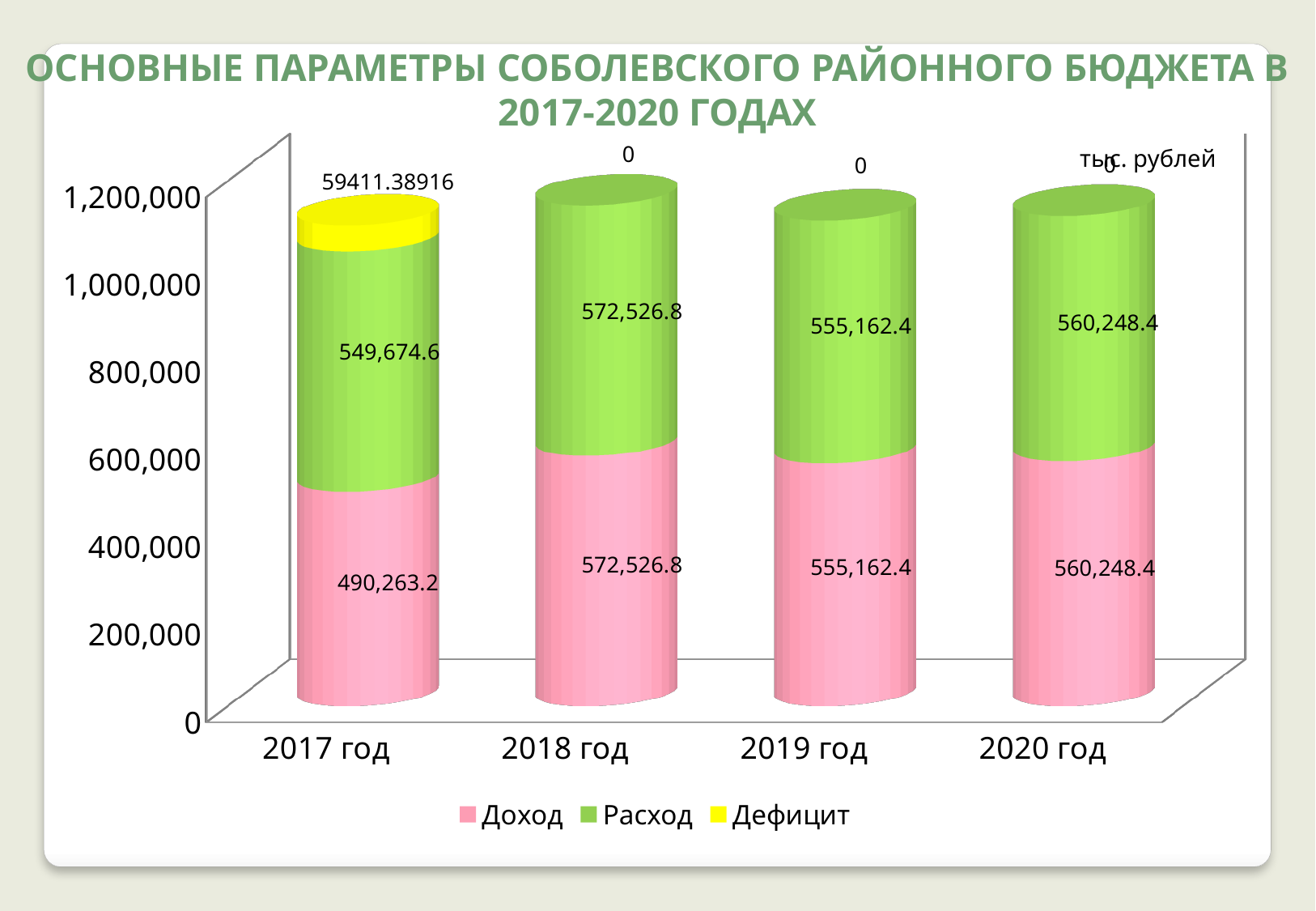
Which year has the lowest Доход value? 2017 год What is the value of Расход for 2018 год? 572,526.8 Which year has the highest Доход value? 2018 год What is the difference between Расход in 2018 год and Расход in 2020 год? 12,278.4 What kind of chart is shown on the slide? Stacked bar chart What is the value of Дефицит for 2017 год? 59411.38916 How many years are shown on the x axis? 4 What is the value of Доход for 2017 год? 490,263.2 What unit of measurement is indicated in the top right of the chart? тыс. рублей Which is larger: Доход in 2019 год or Доход in 2020 год? 2020 год What is the value of Дефицит for 2019 год? 0 How many series does the legend list? 3